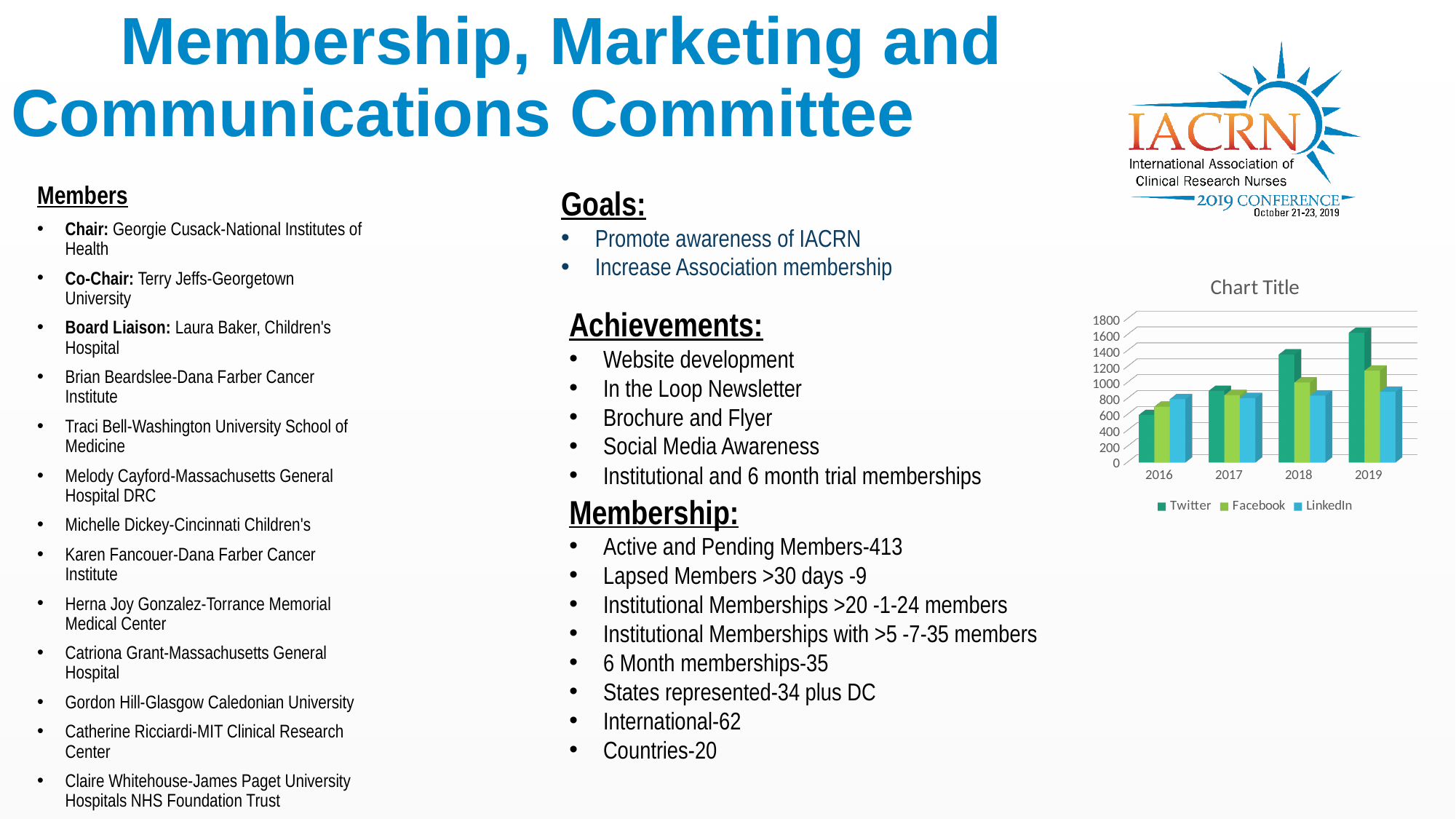
What is the title shown above the chart? Chart Title In which year is the Twitter bar highest? 2019 Is the Twitter value for 2016 greater or less than 800? less How many series does the chart legend list? 3 Which series does the chart legend list first? Twitter Is the LinkedIn value for 2019 greater or less than 1200? less In 2018, which is larger, the Twitter value or the LinkedIn value? Twitter Is the Twitter value for 2019 greater or less than 1400? greater What kind of chart is shown on the slide? bar chart How many years are shown on the x axis of the chart? 4 In which year is the Twitter bar lowest? 2016 Do the Twitter values rise or fall from 2016 to 2019? rise